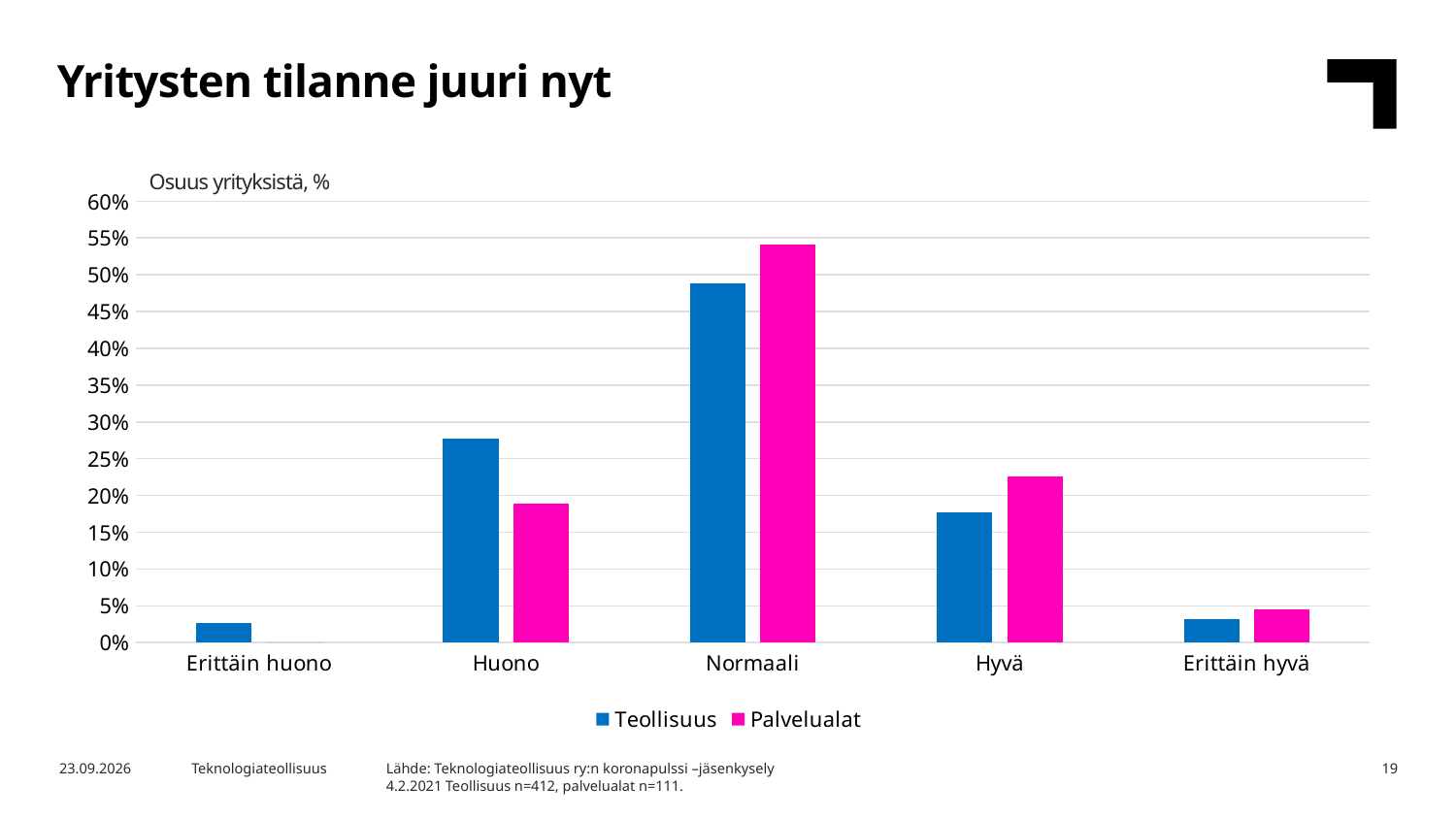
In the Huono category, which series has the larger value, Teollisuus or Palvelualat? Teollisuus Is the value for Palvelualat in the Huono category greater or less than 20%? less Which category has the highest value for Palvelualat? Normaali Which category has the lowest value for Palvelualat? Erittäin huono Is the value for Teollisuus in the Normaali category greater or less than 45%? greater Which category has the highest value for Teollisuus? Normaali Is the value for Teollisuus in the Huono category greater or less than 25%? greater How many categories are shown on the x axis? 5 How many series does the legend list? 2 What kind of chart is shown on the slide? bar chart What is the title of the slide? Yritysten tilanne juuri nyt In the Hyvä category, which series has the larger value, Teollisuus or Palvelualat? Palvelualat